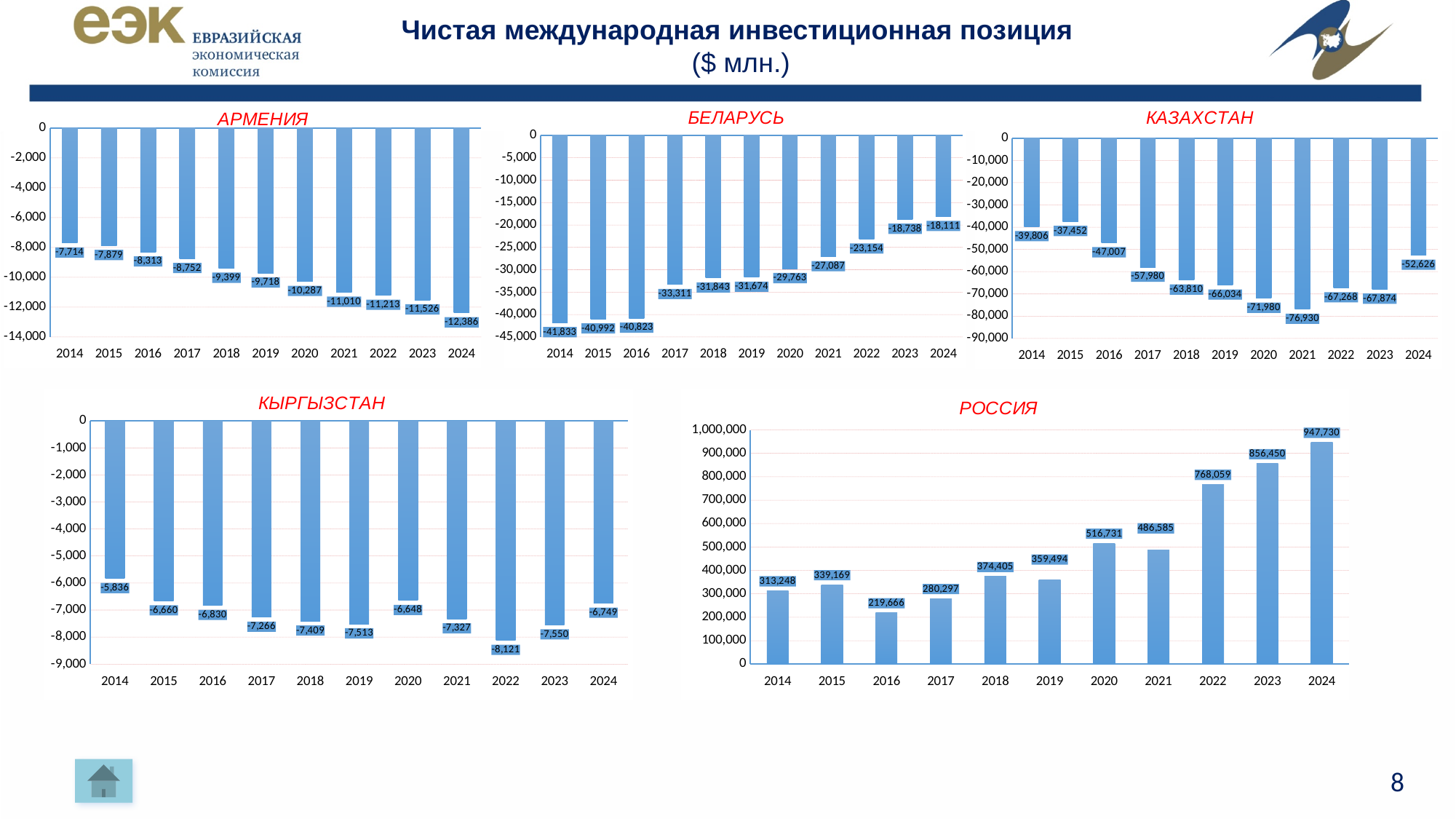
What kind of chart is the РОССИЯ chart? bar chart In the АРМЕНИЯ chart, what is the value for 2024? -12,386 In the КЫРГЫЗСТАН chart, which year has the lowest value? 2022 In the АРМЕНИЯ chart, do the values rise or fall from 2014 to 2024? fall In the РОССИЯ chart, which year has the highest value? 2024 In the РОССИЯ chart, which is larger, the value for 2020 or the value for 2021? 2020 In the РОССИЯ chart, what is the difference between the values for 2024 and 2023? 91,280 In the КЫРГЫЗСТАН chart, what is the value for 2014? -5,836 In the БЕЛАРУСЬ chart, what is the difference between the values for 2014 and 2024? 23,722 In the КАЗАХСТАН chart, which year has the lowest value? 2021 In the БЕЛАРУСЬ chart, what is the value for 2017? -33,311 How many years are shown in the АРМЕНИЯ chart? 11